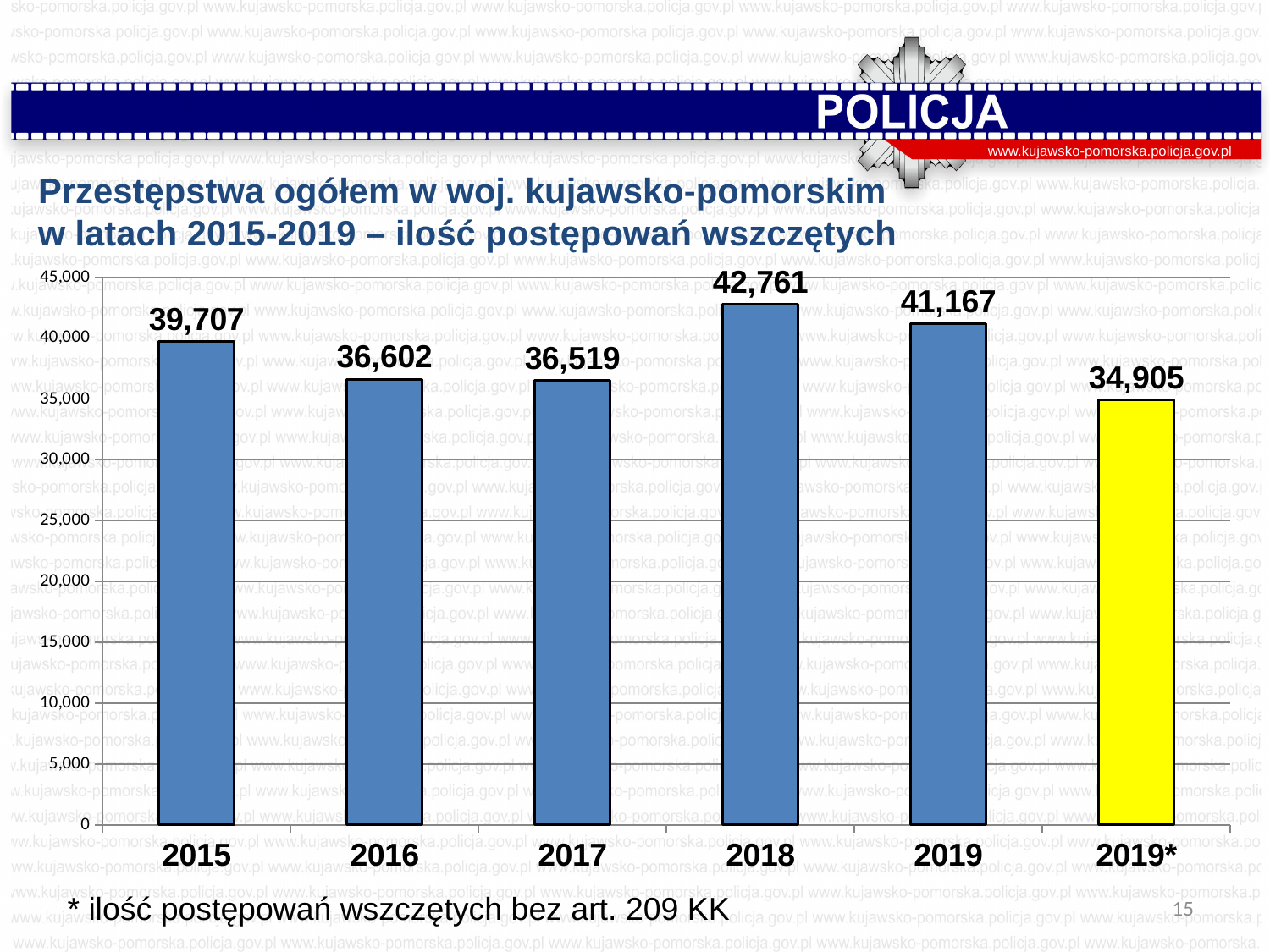
How many bars are shown in the chart? 6 What is the value for 2015? 39,707 Which category has the highest value? 2018 What is the value for 2017? 36,519 Which is larger, the value for 2015 or the value for 2016? 2015 Which category has the lowest value? 2019* Is the value for 2019 greater or less than 40,000? greater What is the difference between the values for 2018 and 2019? 1,594 Which bar is coloured yellow? 2019* What kind of chart is shown on the slide? bar chart Do the values rise or fall from 2018 to 2019*? fall What is the value for 2019*? 34,905